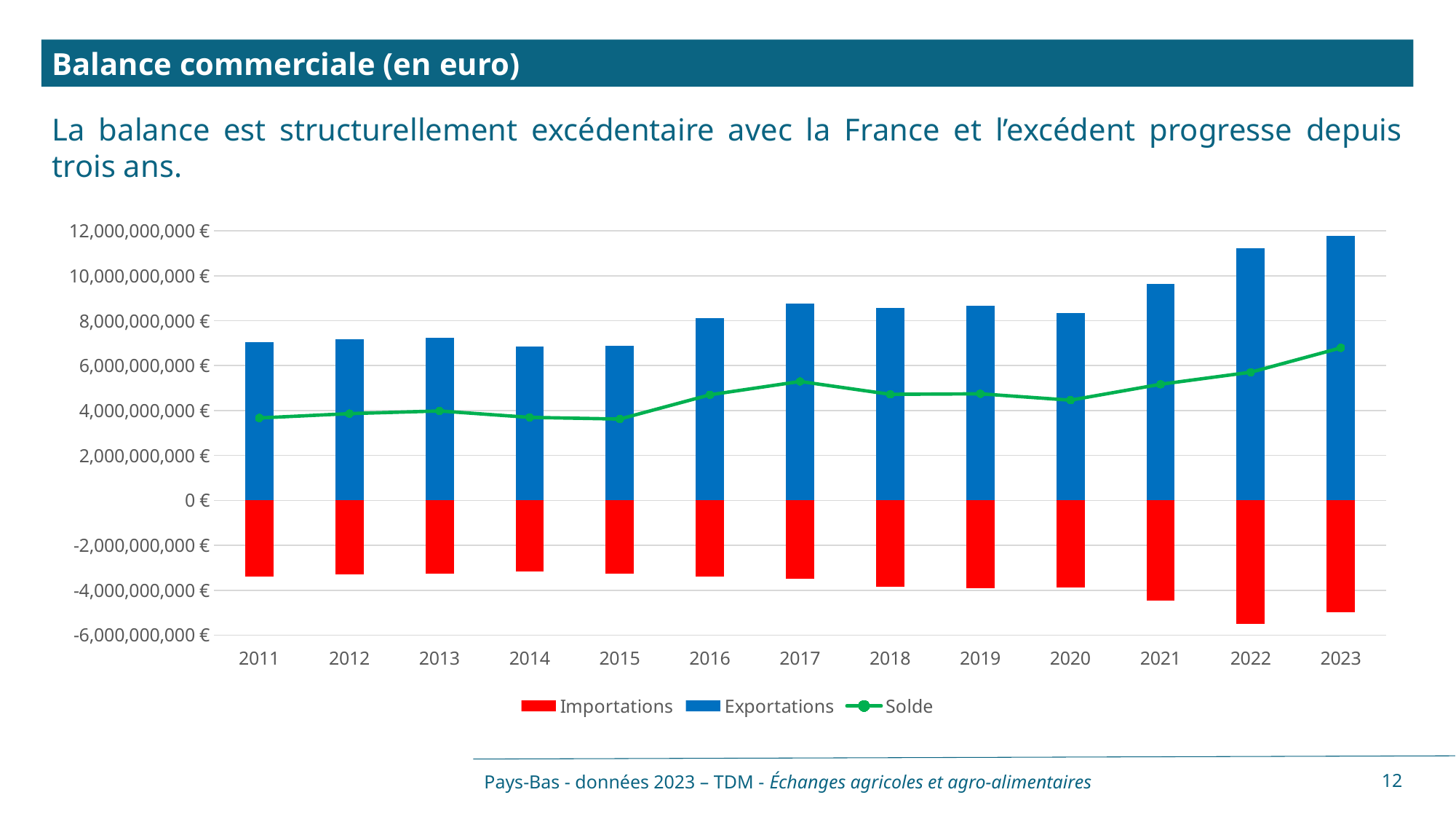
What kind of chart is this? Bar chart with a line series Which is larger, the Solde in 2017 or the Solde in 2020? 2017 Is the value for Solde in 2011 greater or less than 4,000,000,000 €? less Is the value for Exportations in 2023 greater or less than 10,000,000,000 €? greater Overall, do the Exportations values rise or fall from 2011 to 2023? rise Which year has the lowest (most negative) value for Importations? 2022 How many series does the legend list? 3 Which year has the highest value for Exportations? 2023 How many years are shown on the x axis? 13 What is the title of the chart? Balance commerciale (en euro) Is the value for Importations in 2022 greater or less than -4,000,000,000 €? less Which year has the highest value for Solde? 2023